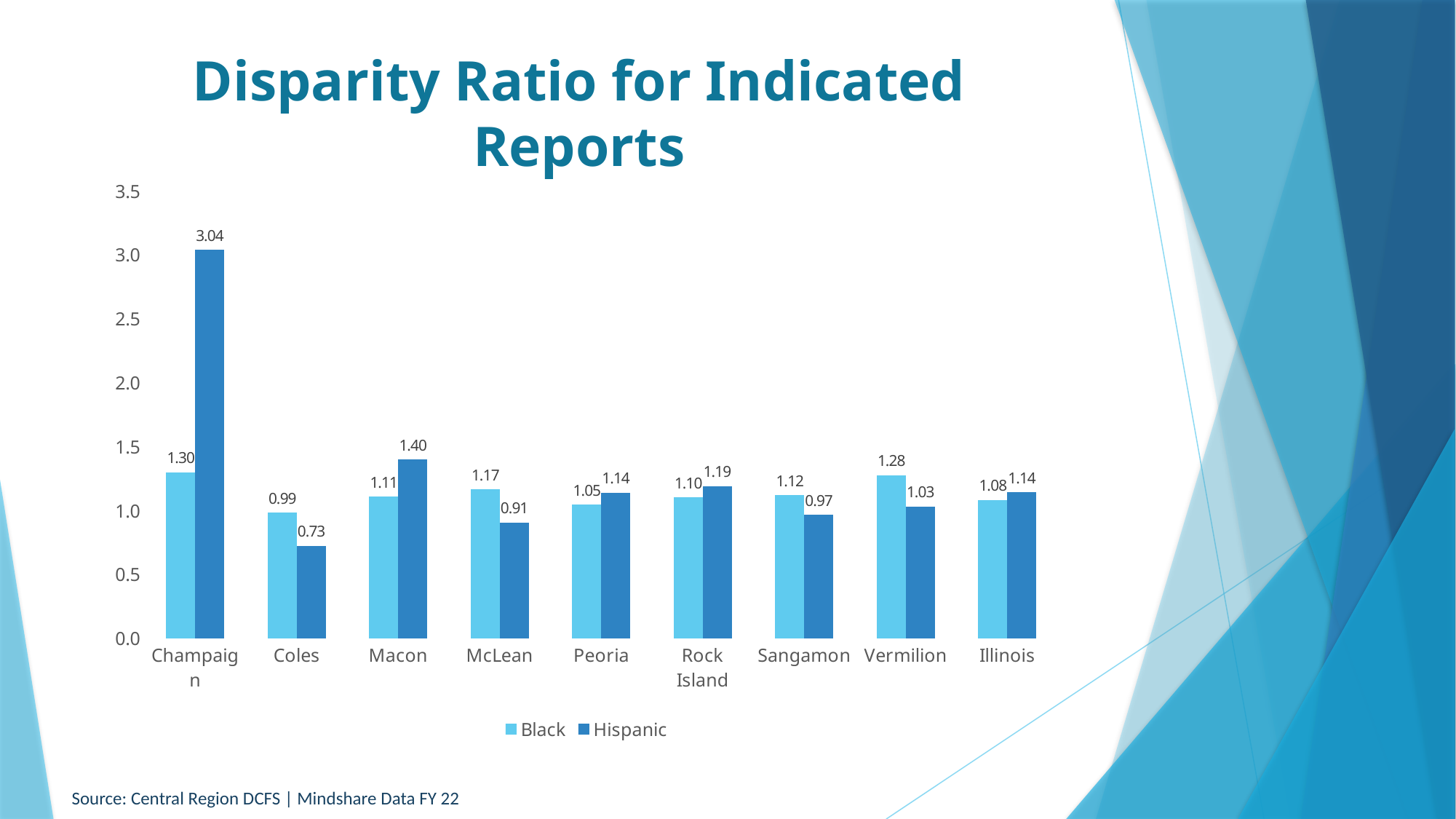
What is the title of the chart? Disparity Ratio for Indicated Reports Which category has the highest Hispanic disparity ratio? Champaign What kind of chart is shown on the slide? Bar chart What is the difference between the Hispanic and Black disparity ratios for Champaign? 1.74 What is the Hispanic disparity ratio for Champaign? 3.04 Which category has the lowest Black disparity ratio? Coles Which is larger for McLean, the Black or the Hispanic disparity ratio? Black How many categories are shown on the x axis? 9 What is the Hispanic disparity ratio for Coles? 0.73 What is the Black disparity ratio for Vermilion? 1.28 How many series does the legend list? 2 Is the Hispanic value for Champaign greater or less than 3.0? greater